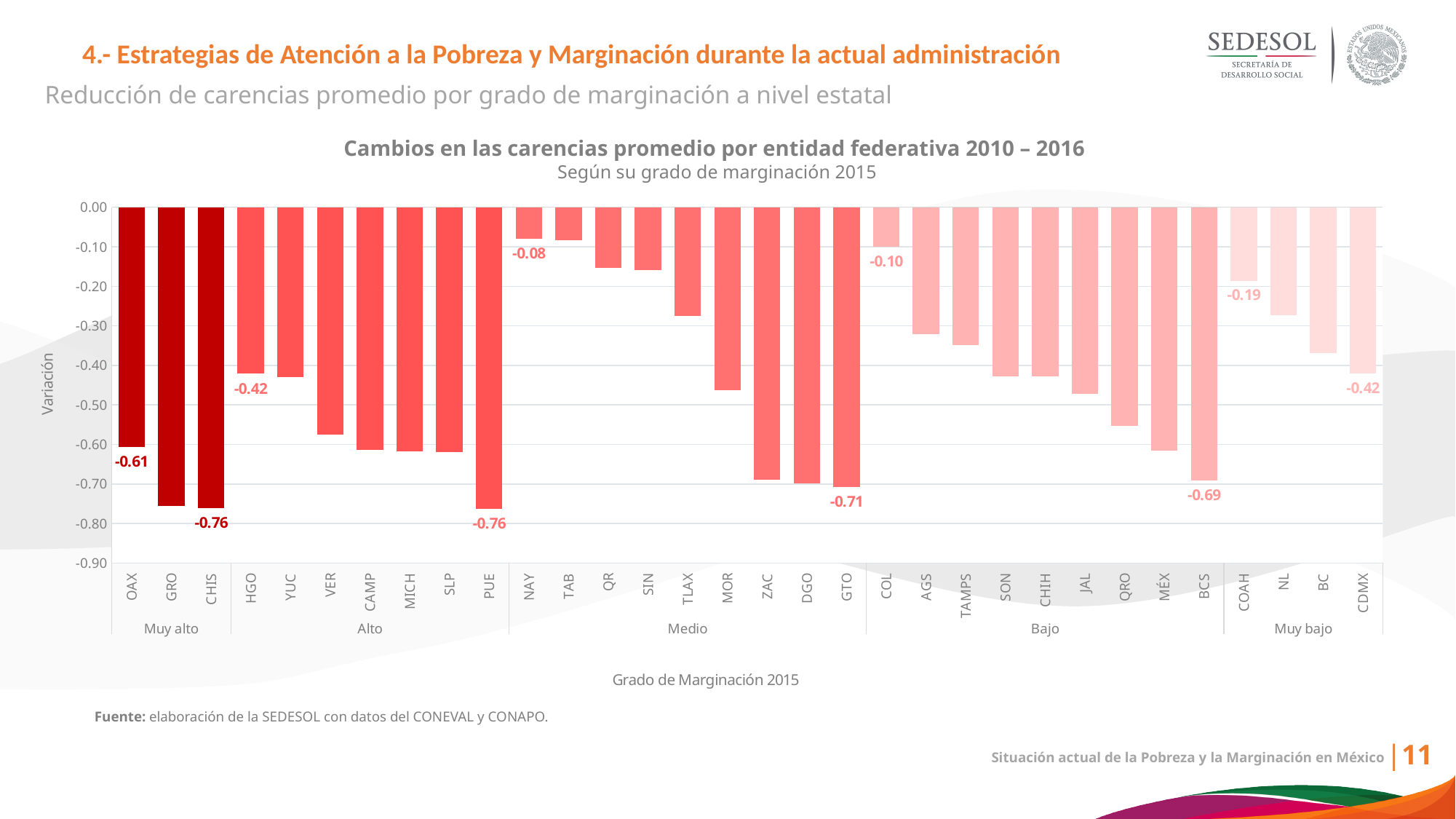
How many states are in the 'Muy bajo' group? 4 How many states are plotted in the chart? 32 What is the difference between the values for CHIS and OAX? 0.15 Is the bar for GRO above or below -0.70 on the axis? below What is the value shown for OAX? -0.61 What is the value shown for COL? -0.10 Which state shows the smallest change (closest to zero)? NAY What is the value shown for NAY? -0.08 What is the value shown for CDMX? -0.42 What kind of chart is shown? bar chart